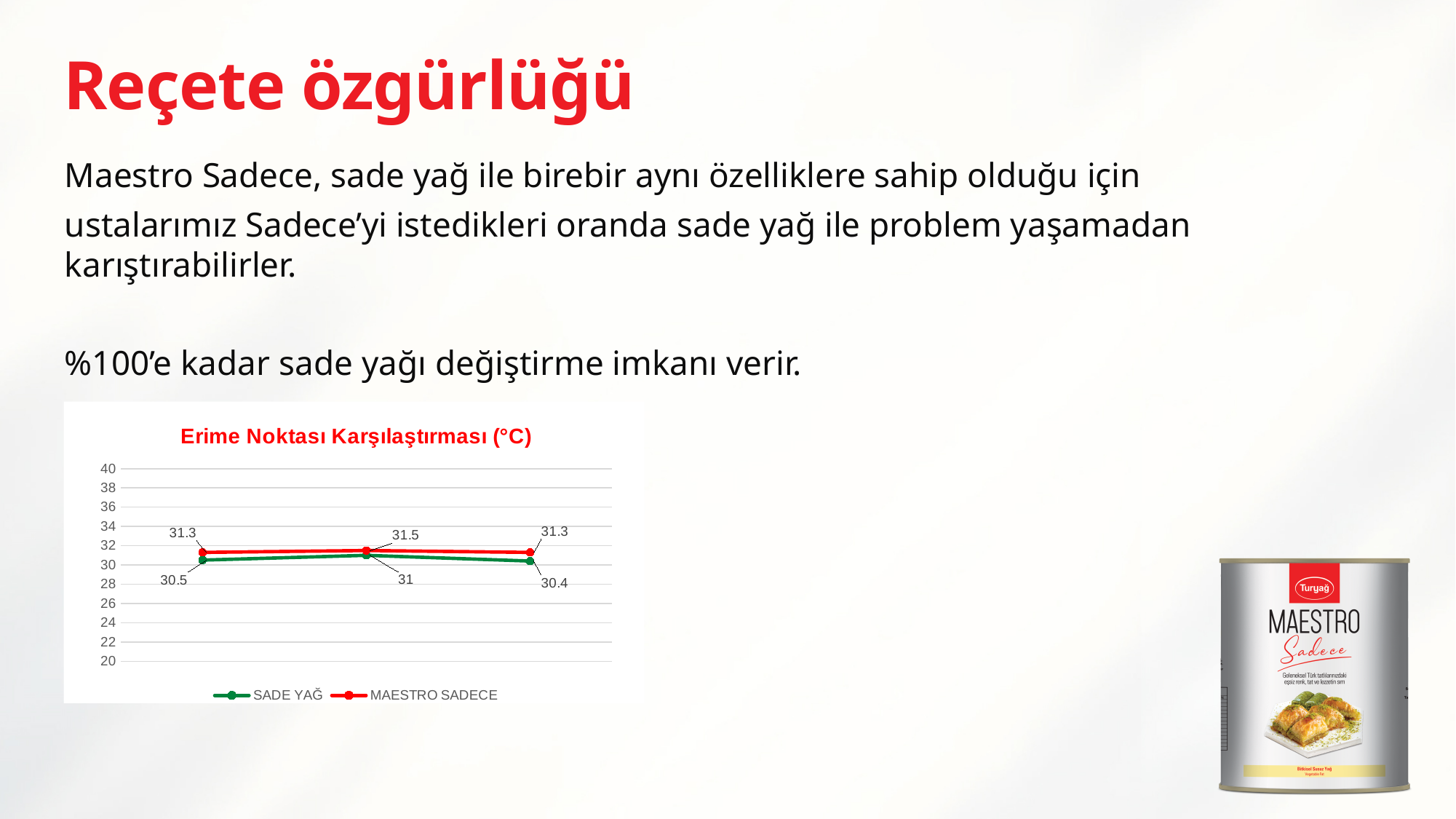
What is the value of the last data point of the SADE YAĞ series? 30.4 What is the difference between the middle data points of MAESTRO SADECE (31.5) and SADE YAĞ (31)? 0.5 How many data points does each line in the chart have? 3 What is the highest value plotted for the MAESTRO SADECE series? 31.5 What is the value of the first data point of the MAESTRO SADECE series? 31.3 Which series has the higher value at the first data point, SADE YAĞ or MAESTRO SADECE? MAESTRO SADECE How many series does the chart legend list? 2 What is the title of the chart? Erime Noktası Karşılaştırması (°C) What type of chart is shown on the slide? line chart Which colour is used for the SADE YAĞ line in the chart? green What is the value of the middle data point of the SADE YAĞ series? 31 What is the lowest value plotted for the SADE YAĞ series? 30.4